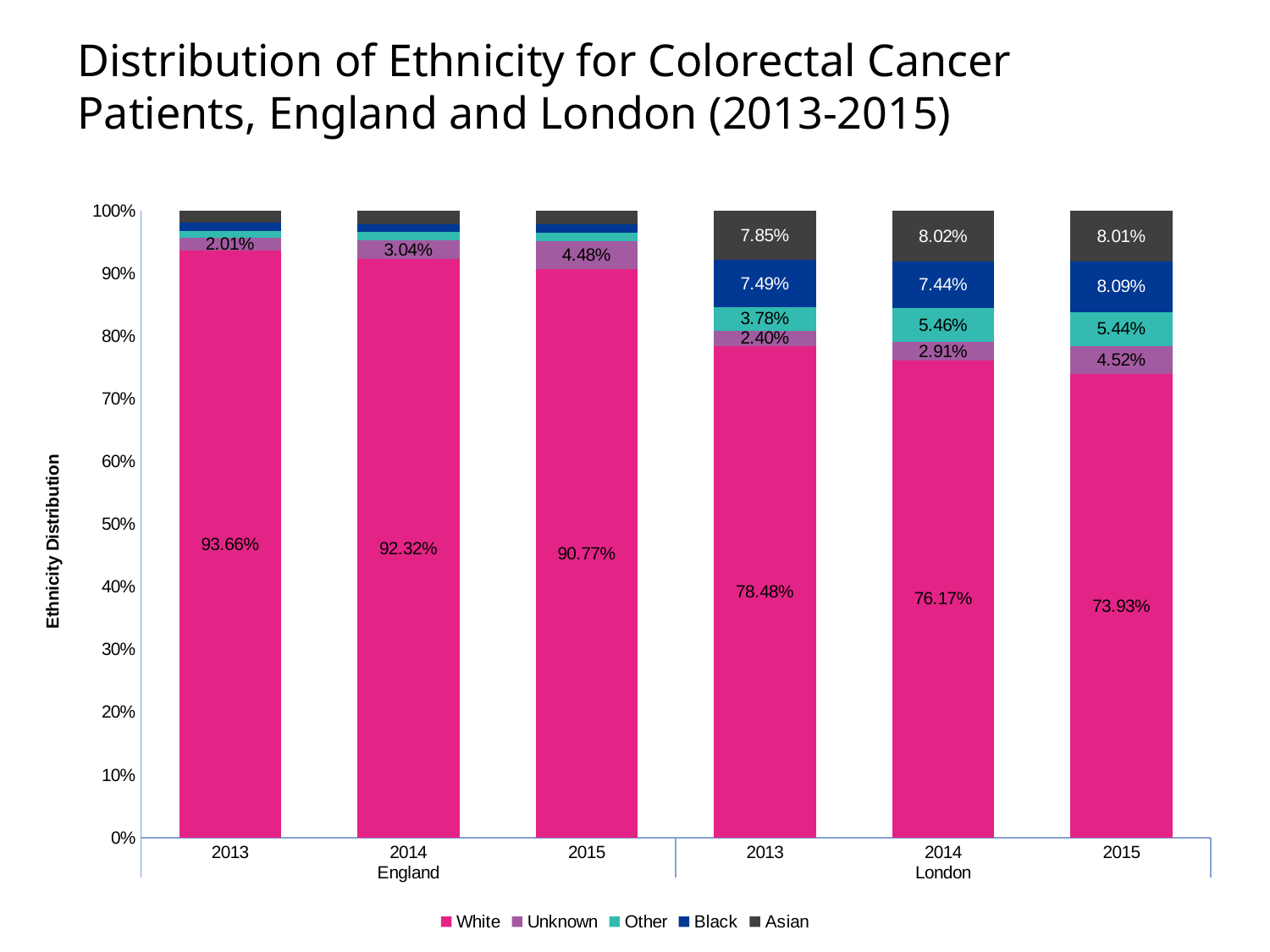
What is the White share for England in 2013? 93.66% What is the Unknown share for England in 2015? 4.48% Which bar has the highest White share? England 2013 Which bar has the lowest White share? London 2015 How many bars are plotted in the chart? 6 What is the Other share for London in 2013? 3.78% What type of chart is shown on the slide? Stacked bar chart What is the Asian share for London in 2014? 8.02% What is the difference between the White share for England in 2013 and the White share for London in 2013? 15.18 percentage points Does the White share for London rise or fall from 2013 to 2015? Fall How many series does the legend list? 5 Which is larger for London in 2014: the Black share or the Asian share? Asian share